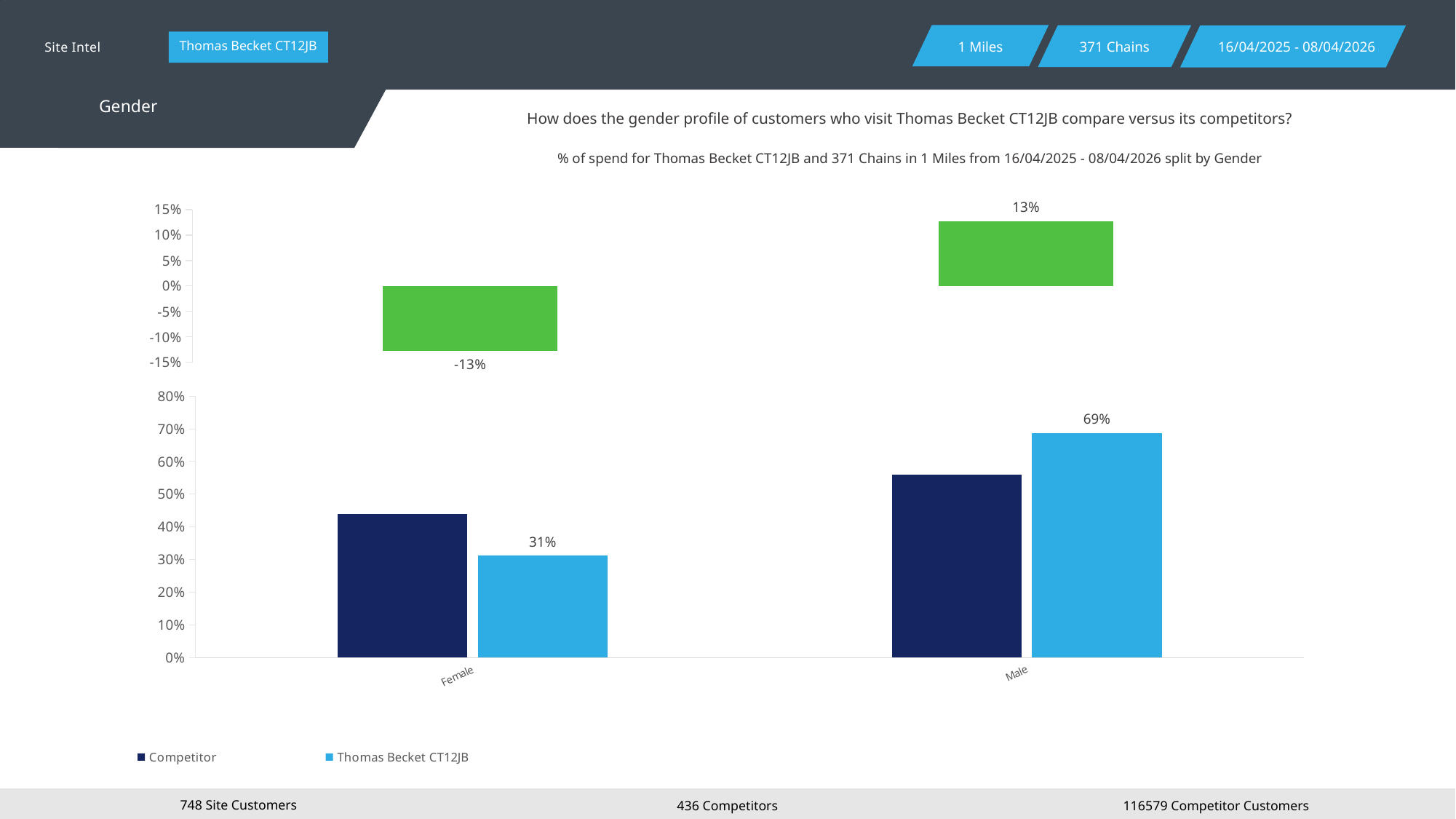
In the bottom chart, is the Competitor value for Male greater or less than 60%? less In the bottom chart, for the Female category, which is larger: the Competitor bar or the Thomas Becket CT12JB bar? Competitor In the bottom chart, which category has the higher value for Thomas Becket CT12JB? Male How many series does the legend of the bottom chart list? 2 In the bottom chart, what is the value for Thomas Becket CT12JB in the Male category? 69% In the top chart, what is the value shown for the Female category? -13% In the bottom chart, is the Competitor value for Female greater or less than 40%? greater In the top chart, what is the value shown for the Male category? 13% In the bottom chart, what is the value for Thomas Becket CT12JB in the Female category? 31% In the bottom chart, for the Male category, which is larger: the Competitor bar or the Thomas Becket CT12JB bar? Thomas Becket CT12JB In the bottom chart, what is the difference between the Thomas Becket CT12JB values for Male and Female? 38% What kind of chart is the bottom chart? Bar chart